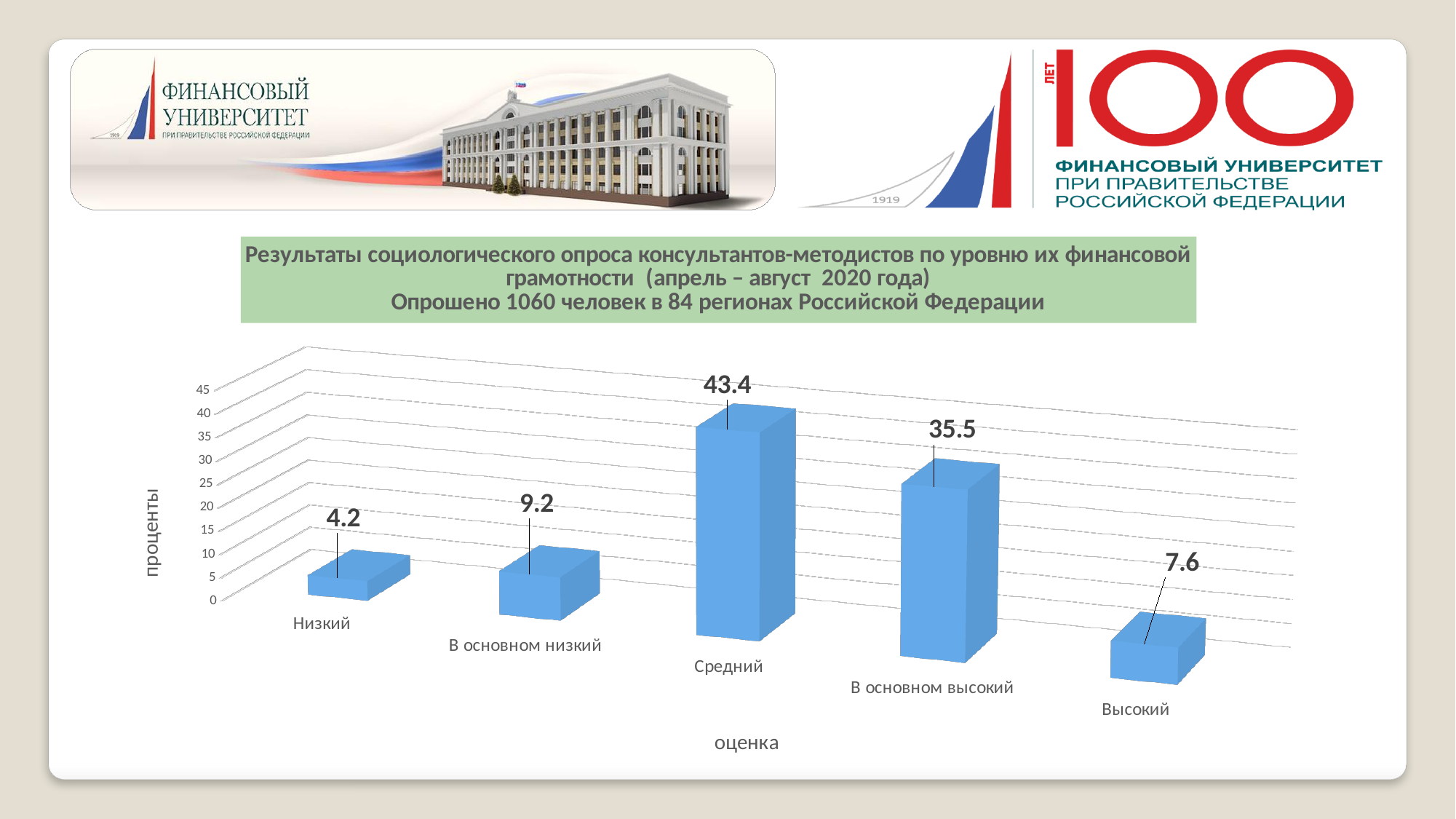
Which is larger, the value for "В основном низкий" or the value for "Высокий"? В основном низкий Which category has the lowest value? Низкий What is the difference between the values for "Средний" and "В основном высокий"? 7.9 What is the label of the horizontal axis? оценка What is the label of the vertical axis? проценты What is the value for the category "Средний"? 43.4 Is the value for "В основном высокий" greater or less than 30? greater What kind of chart is shown on the slide? bar chart What is the value for the category "Низкий"? 4.2 Which category has the highest value? Средний What is the value for the category "В основном высокий"? 35.5 How many categories are shown on the x axis? 5